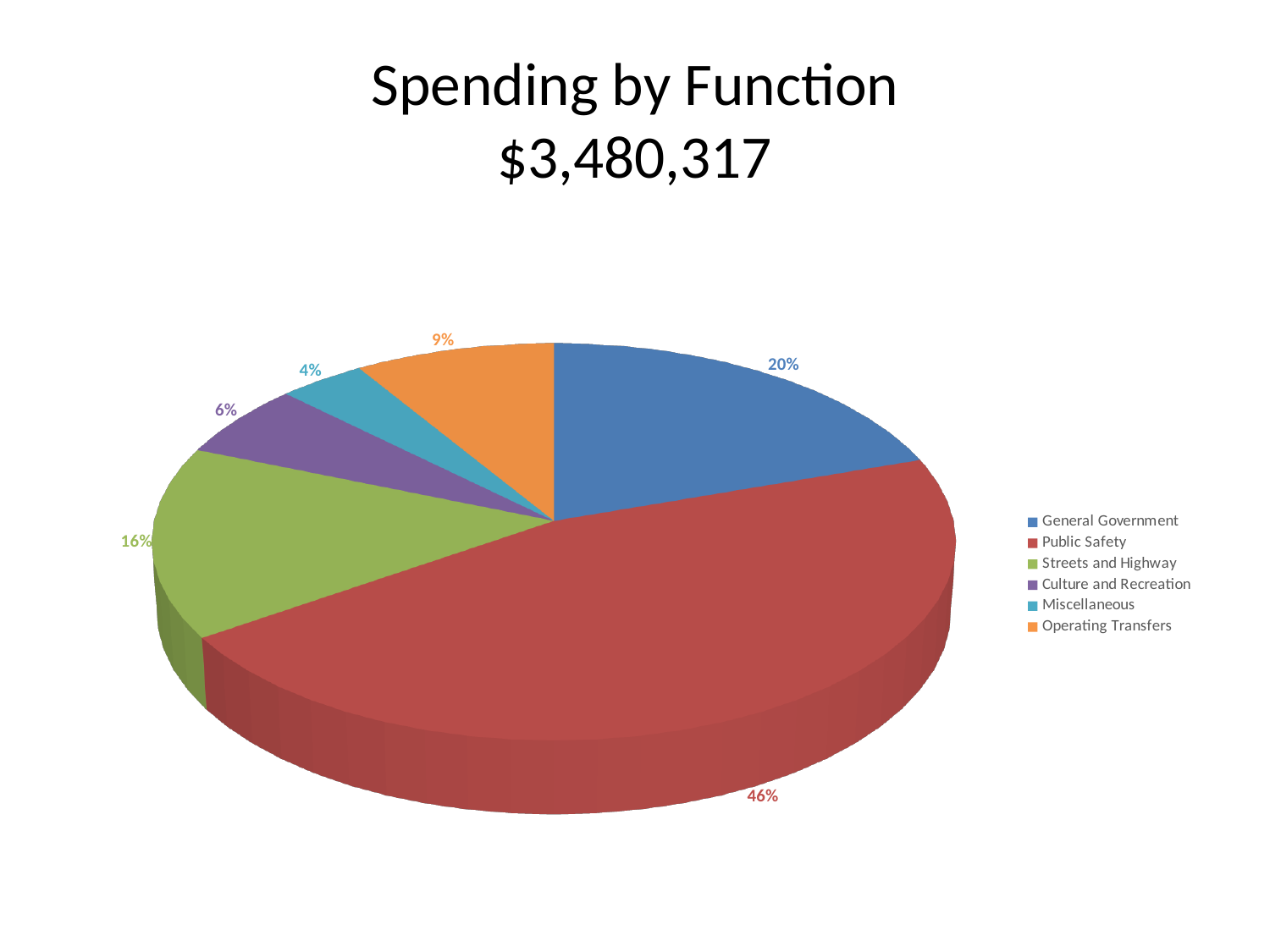
What kind of chart is shown on the slide? Pie chart Which function has the largest share of spending? Public Safety What share of spending goes to Miscellaneous? 4% How many slices does the pie chart have? 6 Which has a larger share, Culture and Recreation or Operating Transfers? Operating Transfers What share of spending goes to General Government? 20% What share of spending goes to Streets and Highway? 16% What total spending amount is shown in the chart title? $3,480,317 Which function has the smallest share of spending? Miscellaneous What is the difference in percentage points between Public Safety and General Government? 26 percentage points